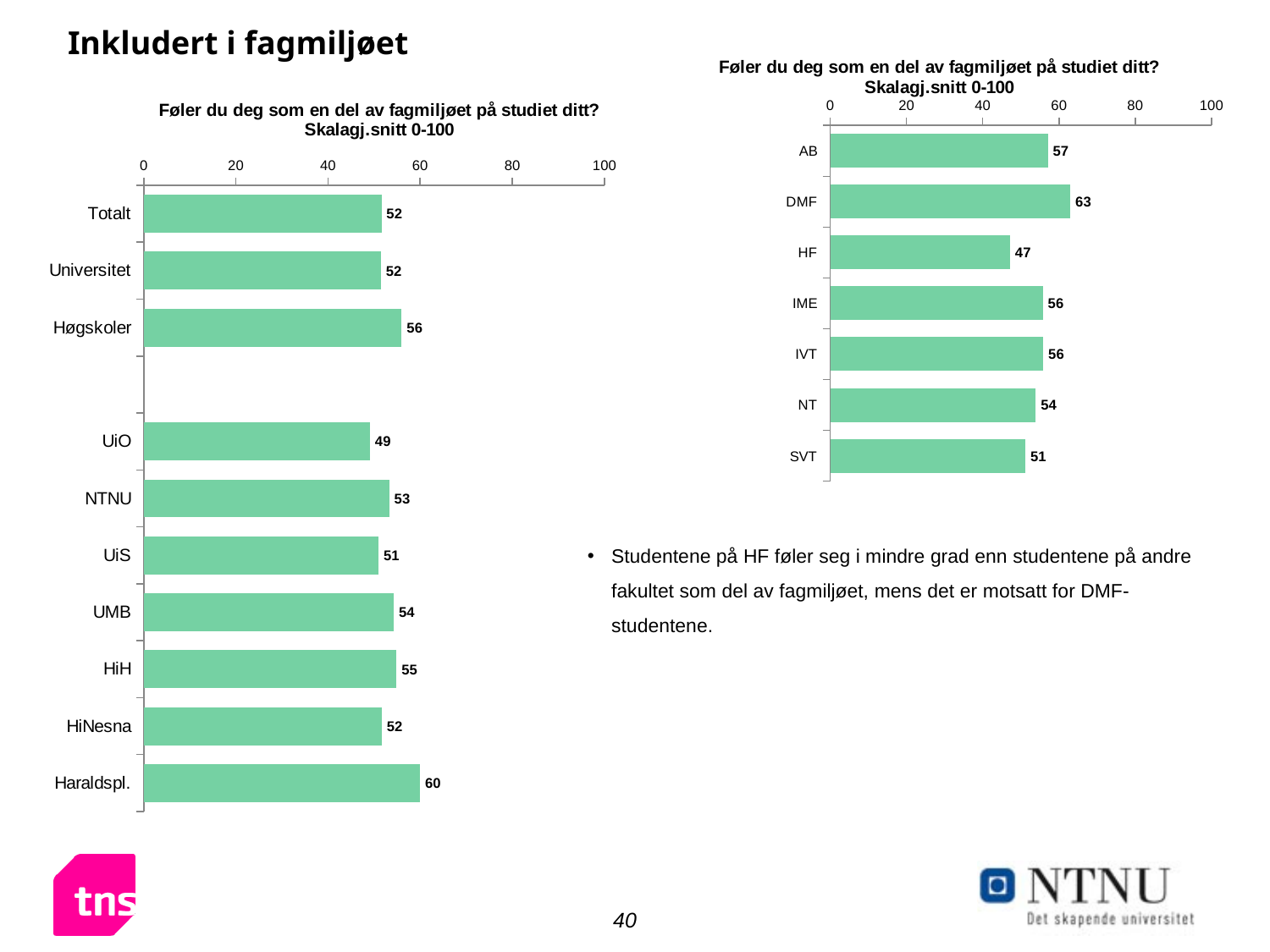
In the left chart, what is the value for Haraldspl.? 60 In the right chart, which faculty has the lowest value? HF In the right chart, how many faculties are shown? 7 In the left chart, which category has the lowest value? UiO In the right chart, what is the difference between the values for DMF and HF? 16 In the left chart, which category has the highest value? Haraldspl. What type of chart is the right chart? Bar chart In the right chart, is the value for SVT greater or less than 60? less In the left chart, what is the value for UiO? 49 In the right chart, what is the value for DMF? 63 In the left chart, what is the difference between the values for Høgskoler and Universitet? 4 In the left chart, which is larger, the value for HiH or the value for UMB? HiH